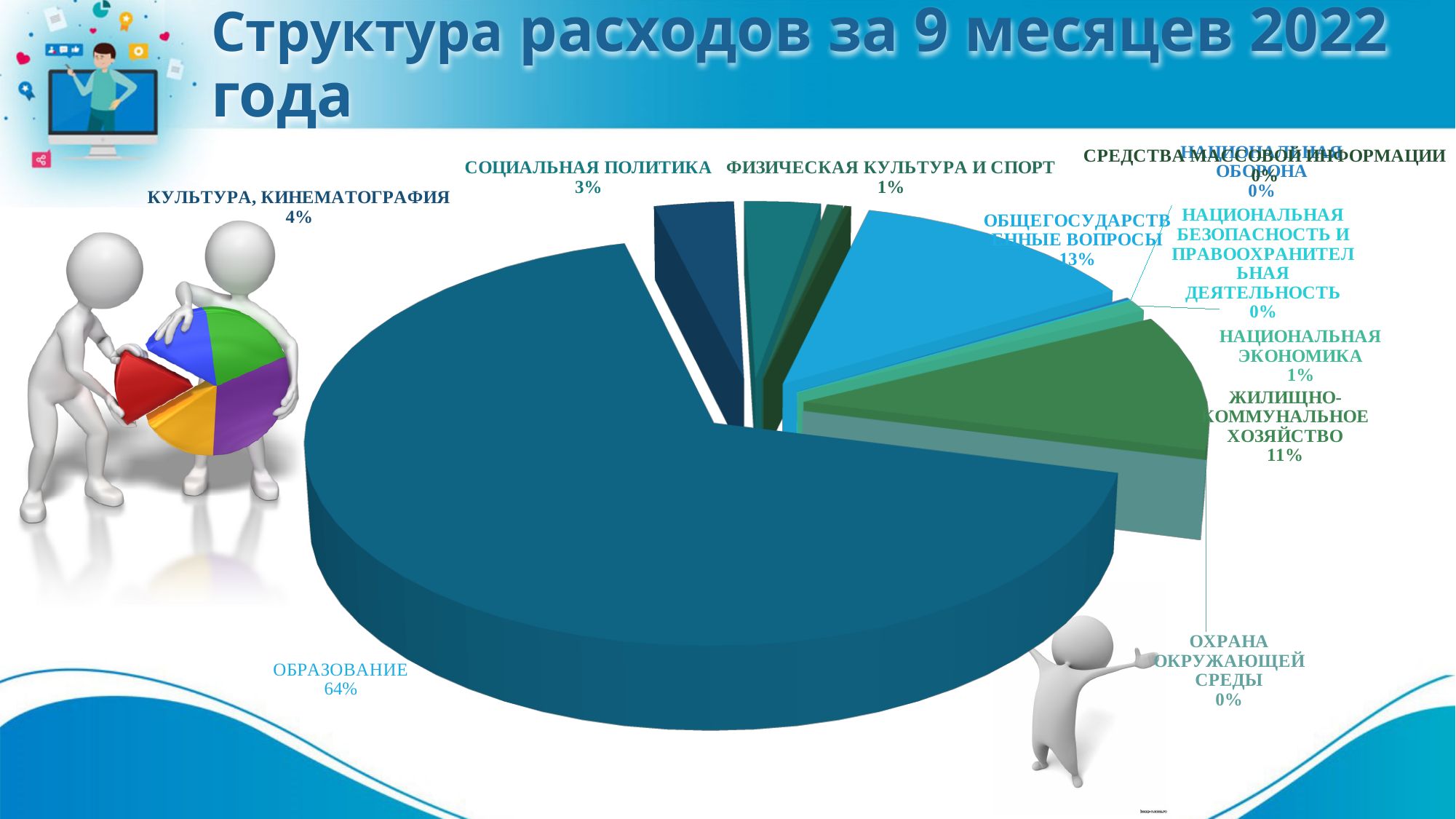
Which category has the largest share of expenditures? ОБРАЗОВАНИЕ What is the combined share of ОБЩЕГОСУДАРСТВЕННЫЕ ВОПРОСЫ and ЖИЛИЩНО-КОММУНАЛЬНОЕ ХОЗЯЙСТВО? 24% What percentage is shown for СОЦИАЛЬНАЯ ПОЛИТИКА? 3% What percentage is shown for ОБЩЕГОСУДАРСТВЕННЫЕ ВОПРОСЫ? 13% What is the title of the slide? Структура расходов за 9 месяцев 2022 года What percentage is shown for ОХРАНА ОКРУЖАЮЩЕЙ СРЕДЫ? 0% What type of chart is shown on the slide? Pie chart Which is larger: the share for ЖИЛИЩНО-КОММУНАЛЬНОЕ ХОЗЯЙСТВО or for КУЛЬТУРА, КИНЕМАТОГРАФИЯ? ЖИЛИЩНО-КОММУНАЛЬНОЕ ХОЗЯЙСТВО What share is labelled for КУЛЬТУРА, КИНЕМАТОГРАФИЯ? 4% What share of expenditures does ОБРАЗОВАНИЕ account for? 64% What percentage is shown for ЖИЛИЩНО-КОММУНАЛЬНОЕ ХОЗЯЙСТВО? 11% What is the difference in percentage points between ОБРАЗОВАНИЕ and ОБЩЕГОСУДАРСТВЕННЫЕ ВОПРОСЫ? 51 percentage points